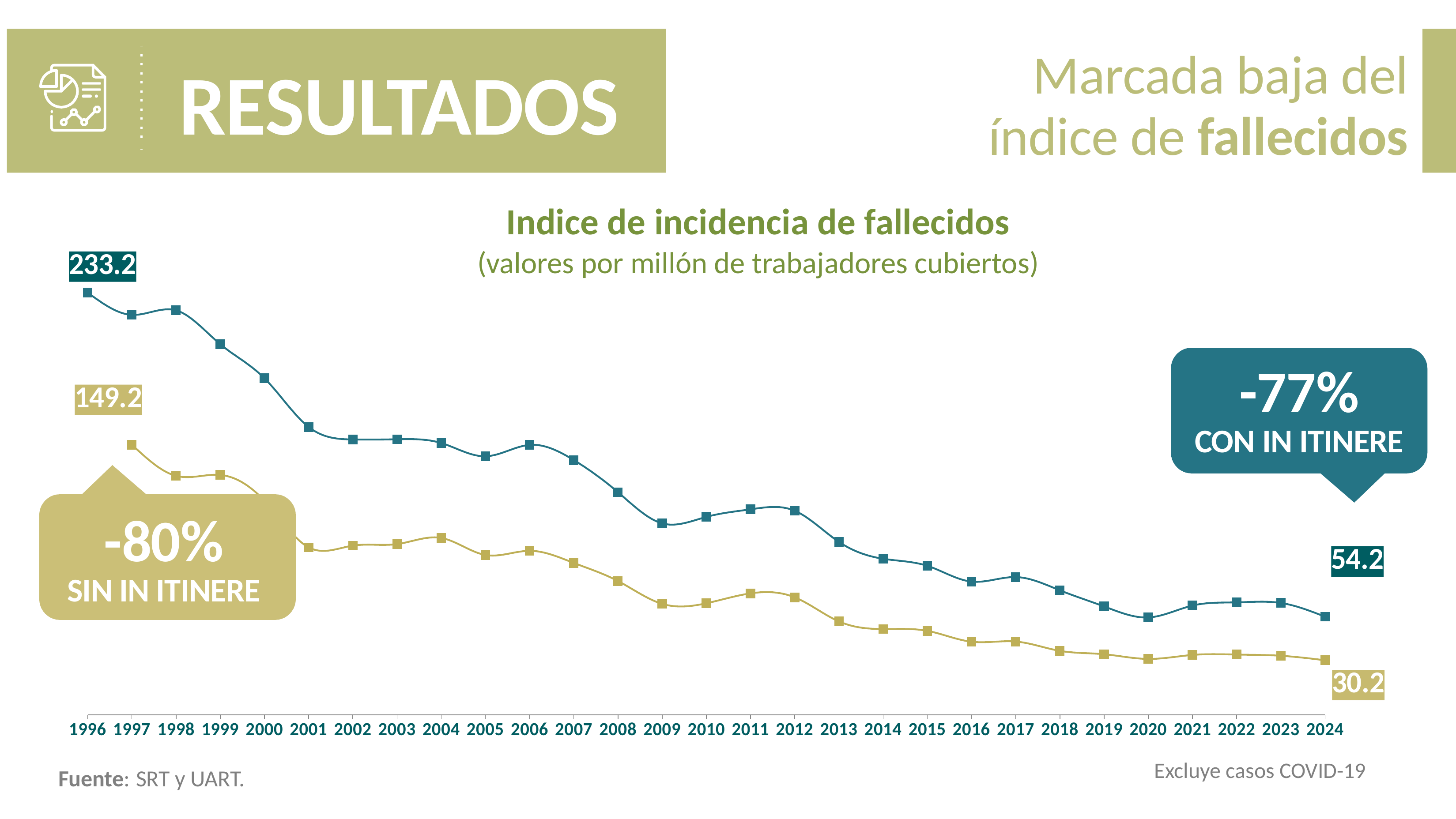
What is the difference between the CON IN ITINERE values in 1996 and 2024? 179.0 How many years are shown on the x axis? 29 What is the value of the CON IN ITINERE series in 1996? 233.2 What is the first labelled value of the SIN IN ITINERE series? 149.2 In 2024, what is the difference between the CON IN ITINERE and SIN IN ITINERE values? 24.0 In 2024, which series has the higher value, CON IN ITINERE or SIN IN ITINERE? CON IN ITINERE Do the values of the CON IN ITINERE series generally rise or fall from 1996 to 2024? fall What is the value of the SIN IN ITINERE series in 2024? 30.2 What is the value of the CON IN ITINERE series in 2024? 54.2 In which year does the CON IN ITINERE series reach its highest value? 1996 What kind of chart is shown on the slide? line chart What percentage change is shown in the callout for the CON IN ITINERE series? -77%